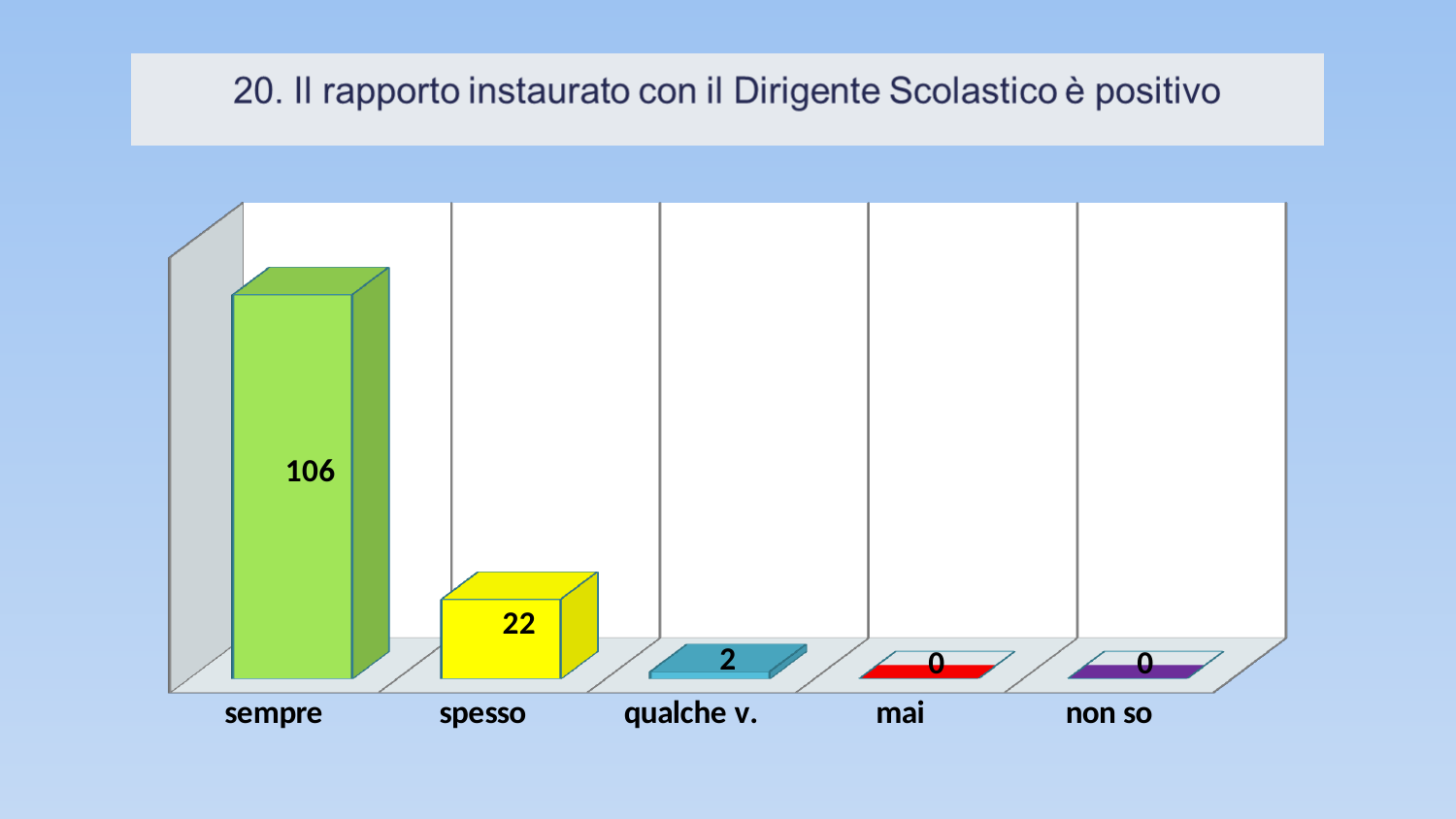
What is the value for "spesso"? 22 What is the value for "sempre"? 106 Which is larger, the value for "spesso" or the value for "qualche v."? spesso What kind of chart is shown on the slide? bar chart What is the title of the chart? 20. Il rapporto instaurato con il Dirigente Scolastico è positivo Which category has the highest value? sempre What is the difference between the values for "sempre" and "spesso"? 84 What is the difference between the values for "spesso" and "qualche v."? 20 What is the value for "mai"? 0 Do the values rise or fall from left to right along the x axis? fall How many categories are shown on the x axis? 5 What is the value for "qualche v."? 2